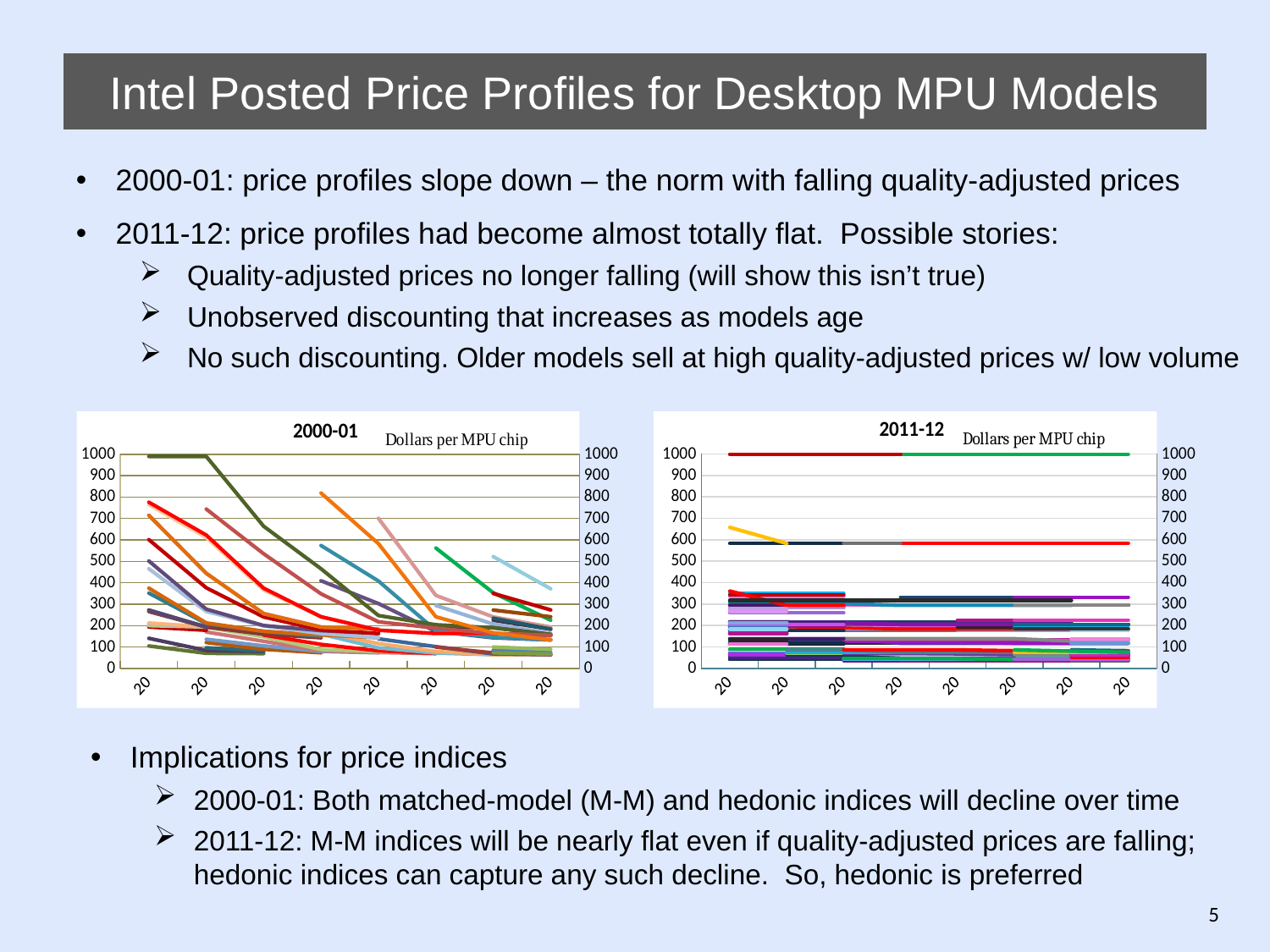
How many x-axis tick labels are shown on the 2000-01 chart? 8 What is the interval between consecutive y-axis tick labels on the 2011-12 chart? 100 In the 2011-12 chart, do the price lines generally rise, fall, or stay flat along the x axis? stay flat How many x-axis tick labels are shown on the 2011-12 chart? 8 What kind of chart is the 2000-01 chart? line chart What is the title of the left chart? 2000-01 In the 2011-12 chart, is the long red line running across the middle of the chart greater or less than 500? greater What unit label is shown next to the title of the 2011-12 chart? Dollars per MPU chip What is the highest value shown on the y axis of the 2000-01 chart? 1000 In the 2000-01 chart, do the price lines generally rise or fall along the x axis? fall What kind of chart is the 2011-12 chart? line chart